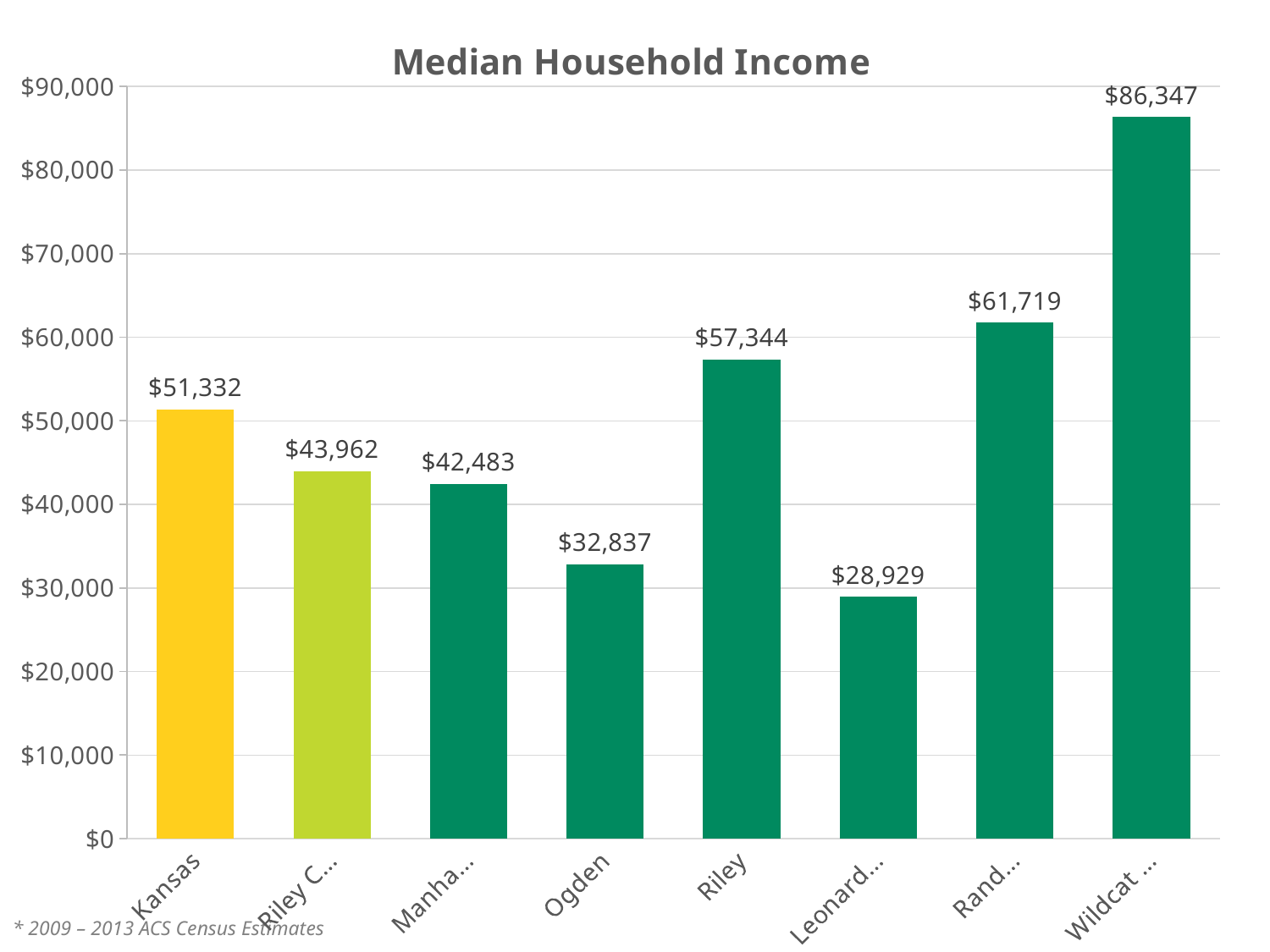
What is the lowest median household income value shown in the chart? $28,929 Which has a higher median household income, Kansas or Riley? Riley What is the difference between the median household income for Riley and for Ogden? $24,507 What is the highest median household income value shown in the chart? $86,347 How many bars are shown in the chart? 8 What is the median household income for Kansas? $51,332 What is the title of the chart? Median Household Income What colour is the bar for Kansas? yellow What is the median household income for Ogden? $32,837 Is the value for Ogden greater or less than $40,000? less What type of chart is shown on the slide? bar chart What is the median household income for Riley? $57,344